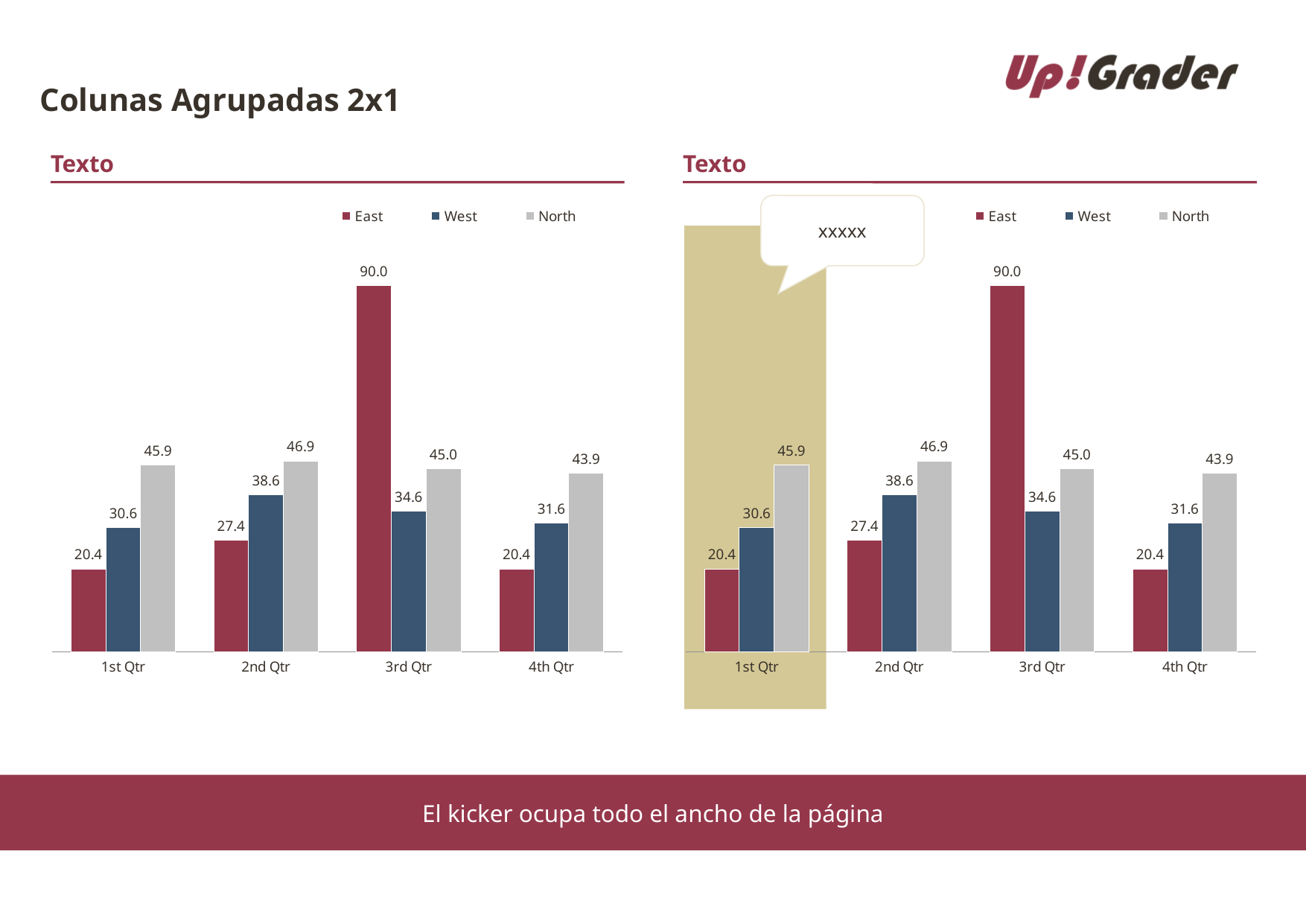
How many quarters are shown on the x axis of the left chart? 4 In the right chart, which quarter has the highest value for East? 3rd Qtr In the left chart, which quarter has the lowest value for West? 1st Qtr How many series does the legend of the right chart list? 3 In the right chart, what is the value for West in 2nd Qtr? 38.6 In the right chart, what is the difference between the North and East values in 1st Qtr? 25.5 In the left chart, what is the difference between the East and West values in 3rd Qtr? 55.4 In the right chart, which is larger in 2nd Qtr: East or West? West In the left chart, what is the value for North in 4th Qtr? 43.9 What kind of chart is the left chart? Bar chart Which series is shown in red in the left chart's legend? East In the left chart, what is the value for East in 3rd Qtr? 90.0